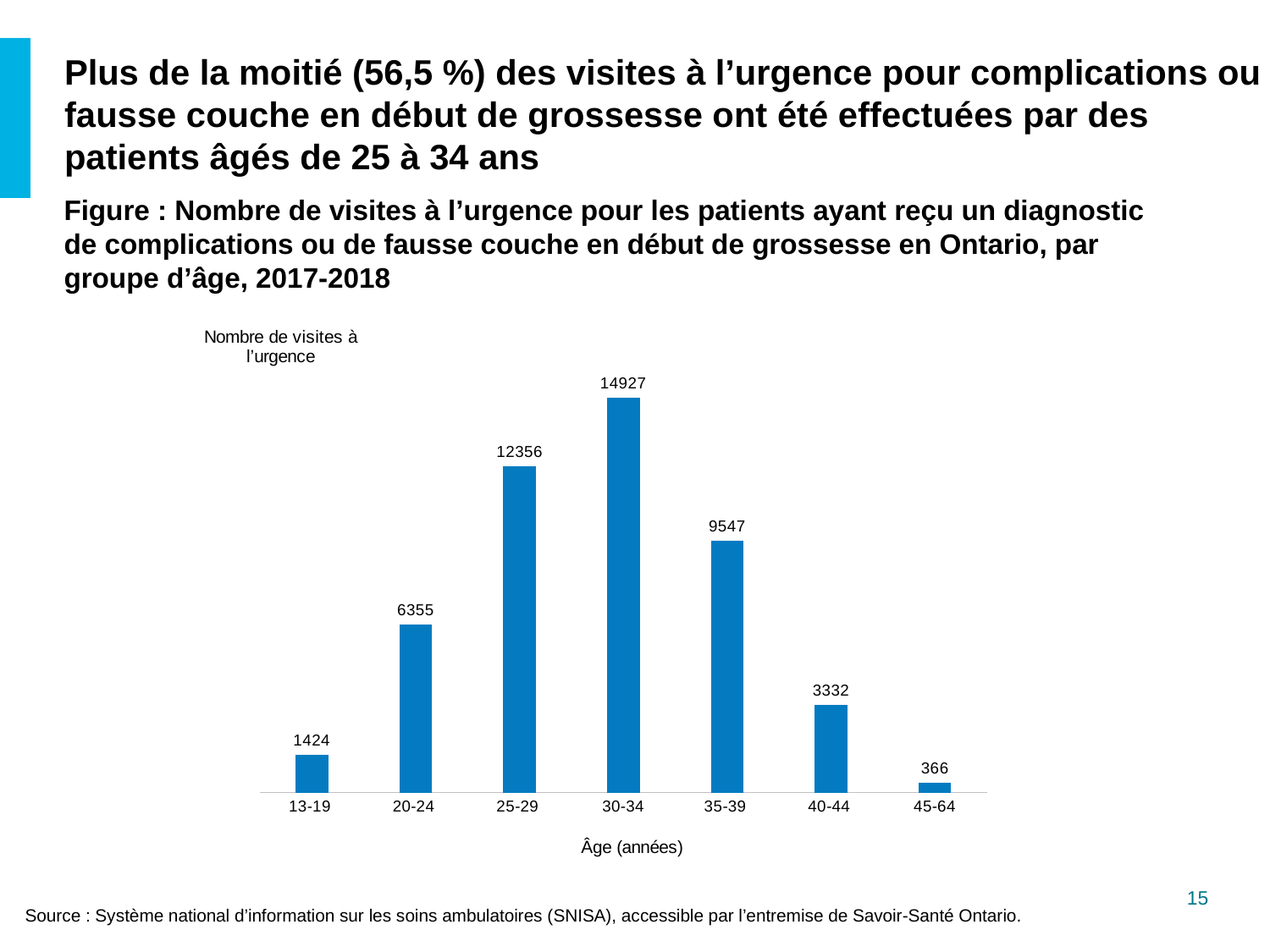
Which age group has more emergency visits, 20-24 or 35-39? 35-39 What is the difference in emergency visits between the 35-39 and 20-24 age groups? 3192 What is the number of emergency visits for the 13-19 age group? 1424 Do the values rise or fall from the 30-34 age group to the 45-64 age group? Fall What is the label of the x axis of the chart? Âge (années) What is the difference in emergency visits between the 30-34 and 25-29 age groups? 2571 What type of chart is shown on the slide? Bar chart Which age group has the highest number of emergency visits? 30-34 How many age groups are shown in the chart? 7 What is the number of emergency visits for the 30-34 age group? 14927 Which age group has the lowest number of emergency visits? 45-64 What is the number of emergency visits for the 40-44 age group? 3332